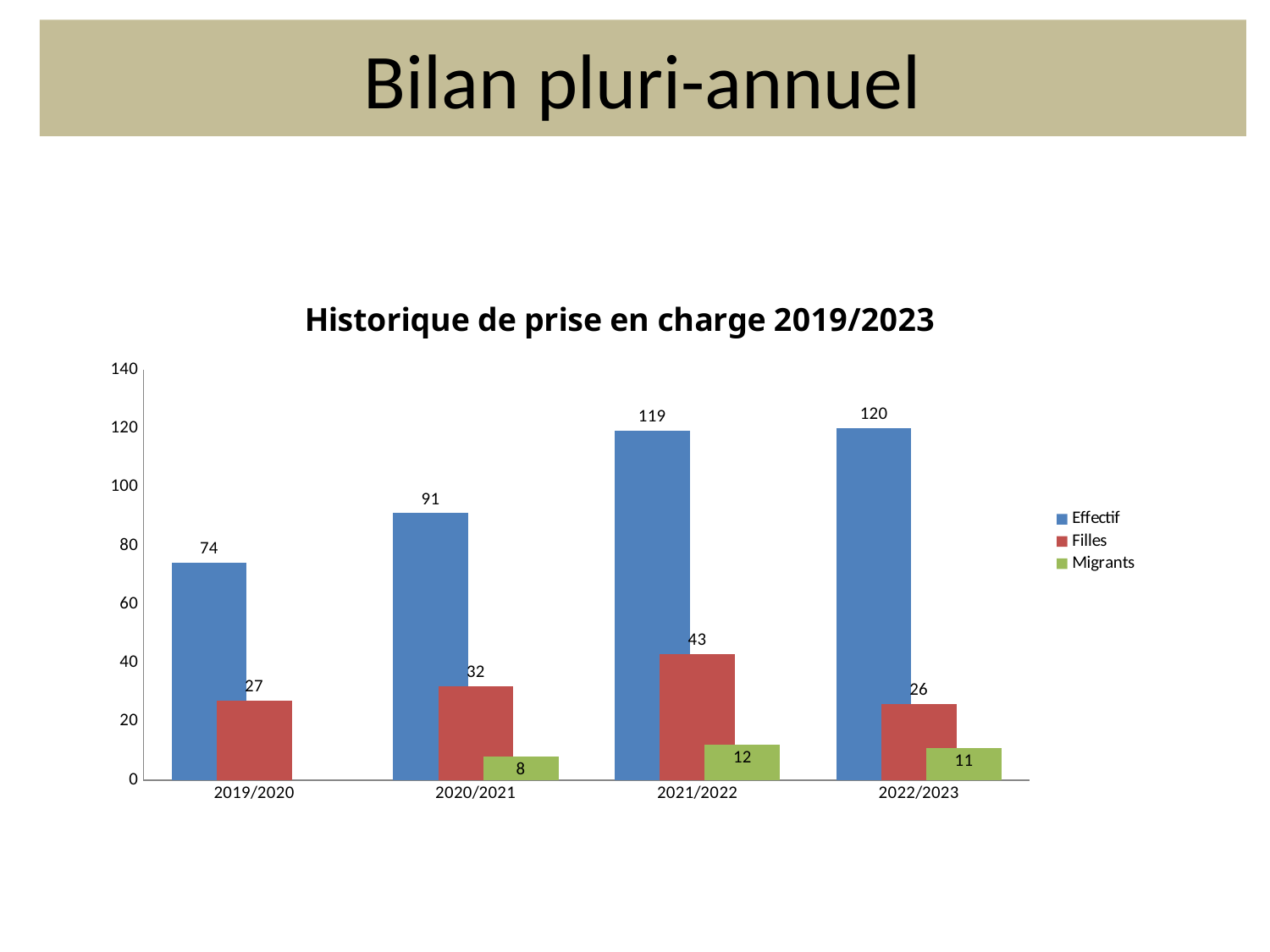
Which is larger, the Filles value for 2020/2021 or for 2022/2023? 2020/2021 What is the Filles value for 2021/2022? 43 How many series does the legend list? 3 Which year has the lowest Filles value? 2022/2023 What kind of chart is shown on the slide? bar chart What is the Effectif value for 2019/2020? 74 Is the Effectif value for 2020/2021 greater or less than 100? less What is the title of the chart? Historique de prise en charge 2019/2023 How many year categories are shown on the x axis? 4 What is the Migrants value for 2020/2021? 8 What is the difference between the Effectif values for 2021/2022 and 2019/2020? 45 Which year has the highest Effectif value? 2022/2023